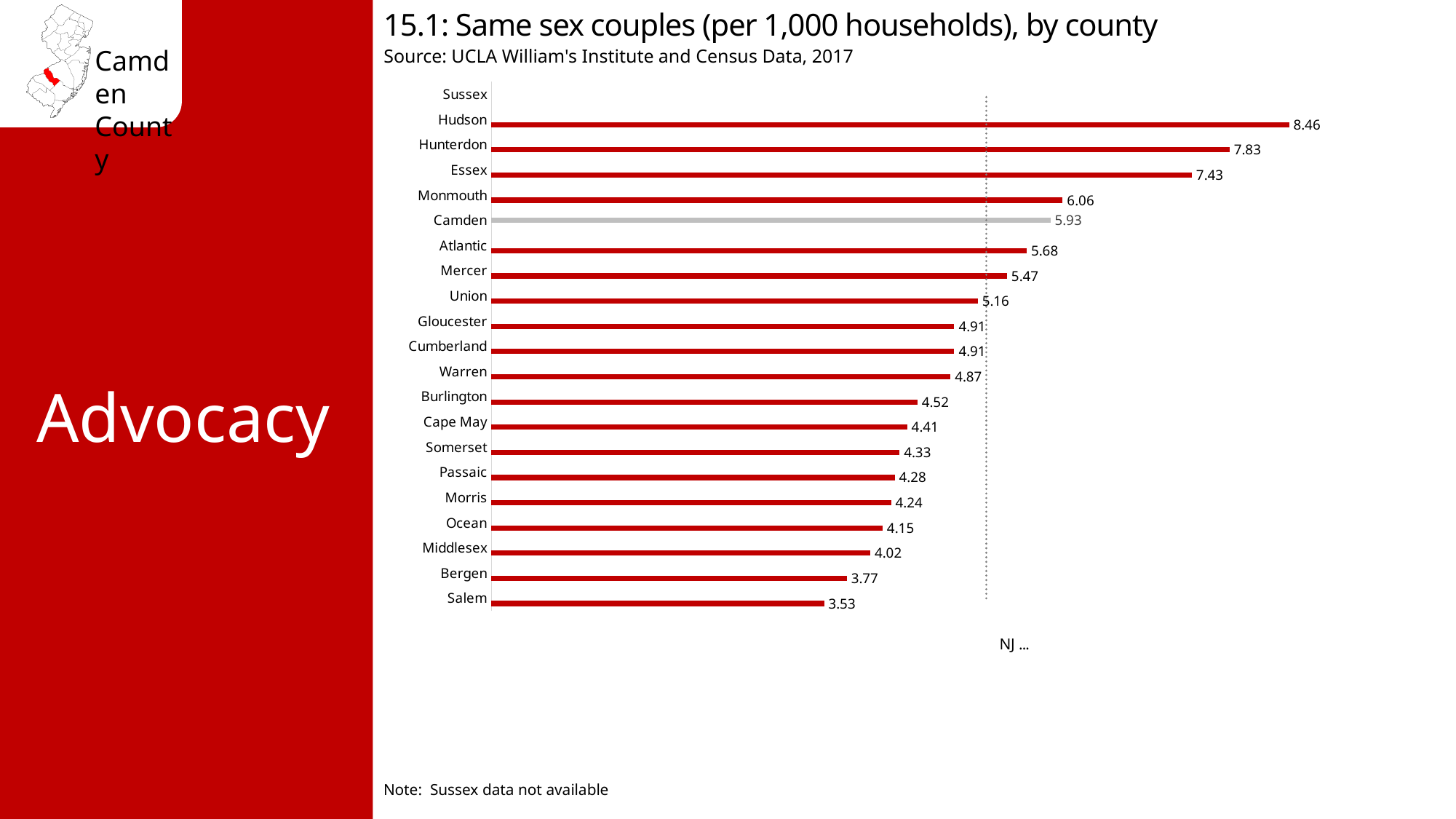
What is the difference between the values for Hudson and Camden? 2.53 What is the value for Bergen? 3.77 How many counties are listed on the y axis of the chart? 21 Which county has the highest value shown? Hudson Which county has the lowest value shown? Salem According to the note, which county's data is not available? Sussex What is the value for Salem? 3.53 What is the value for Hudson? 8.46 Which county's bar is shown in grey rather than red? Camden What kind of chart is shown on the slide? Bar chart Which has a larger value, Monmouth or Atlantic? Monmouth What is the value for Camden in the chart? 5.93